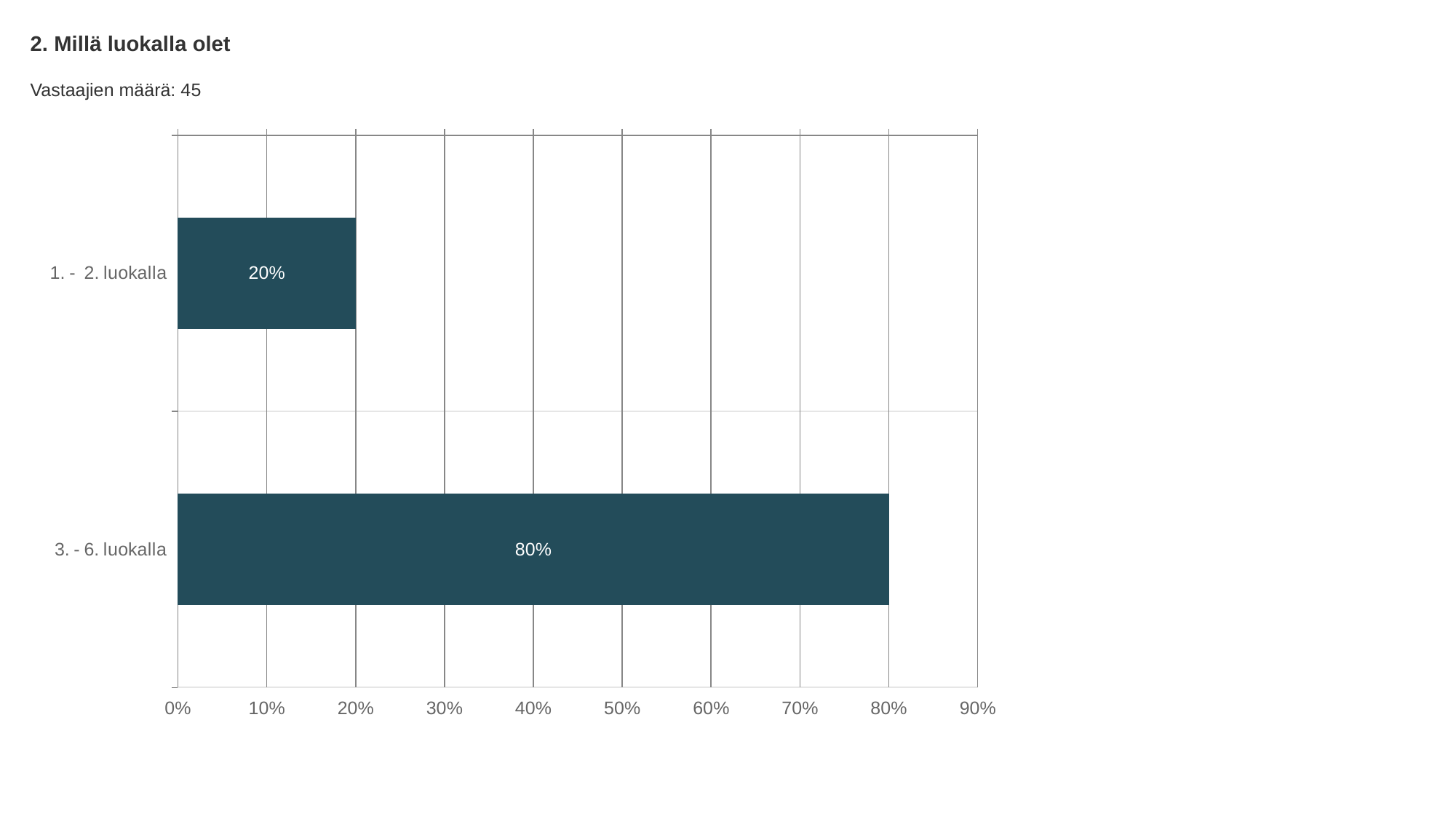
What is the value for "3. - 6. luokalla"? 80% Which category has the highest value? 3. - 6. luokalla How many respondents (Vastaajien määrä) does the slide report? 45 Which is larger, the value for "1. - 2. luokalla" or the value for "3. - 6. luokalla"? 3. - 6. luokalla Is the value for "1. - 2. luokalla" greater or less than 30%? less How many categories are shown in the chart? 2 What is the value for "1. - 2. luokalla"? 20% Which category has the lowest value? 1. - 2. luokalla What is the title of the chart? 2. Millä luokalla olet What kind of chart is shown on the slide? bar chart Is the value for "3. - 6. luokalla" greater or less than 50%? greater What is the difference between the values for "3. - 6. luokalla" and "1. - 2. luokalla"? 60%